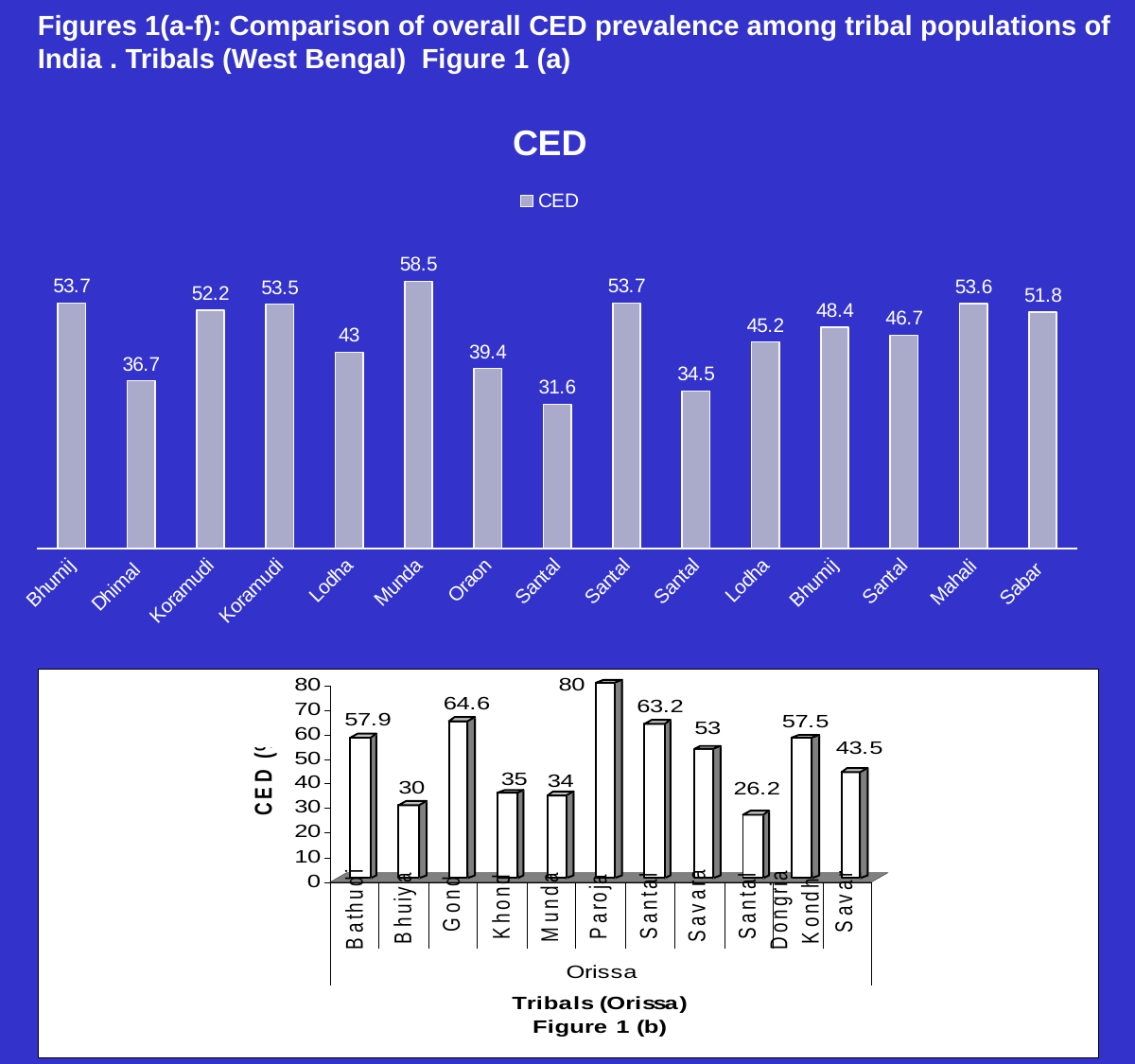
In the bottom chart, Tribals (Orissa) Figure 1 (b), what is the value for Paroja? 80 In the top chart titled CED, what is the value for Munda? 58.5 In the top chart titled CED, which is larger, the value for Mahali or the value for Sabar? Mahali In the bottom chart, Tribals (Orissa) Figure 1 (b), which category has the highest value? Paroja In the bottom chart, Tribals (Orissa) Figure 1 (b), what is the value for Bhuiya? 30 In the top chart titled CED, how many bars are plotted? 15 In the top chart titled CED, which category has the highest value? Munda In the top chart titled CED, what is the value for Dhimal? 36.7 In the top chart titled CED, what is the difference between the values for Munda and Dhimal? 21.8 In the top chart titled CED, what is the value for Oraon? 39.4 What kind of chart is the bottom chart, Tribals (Orissa) Figure 1 (b)? Bar chart In the bottom chart, Tribals (Orissa) Figure 1 (b), what is the difference between the values for Paroja and Munda? 46